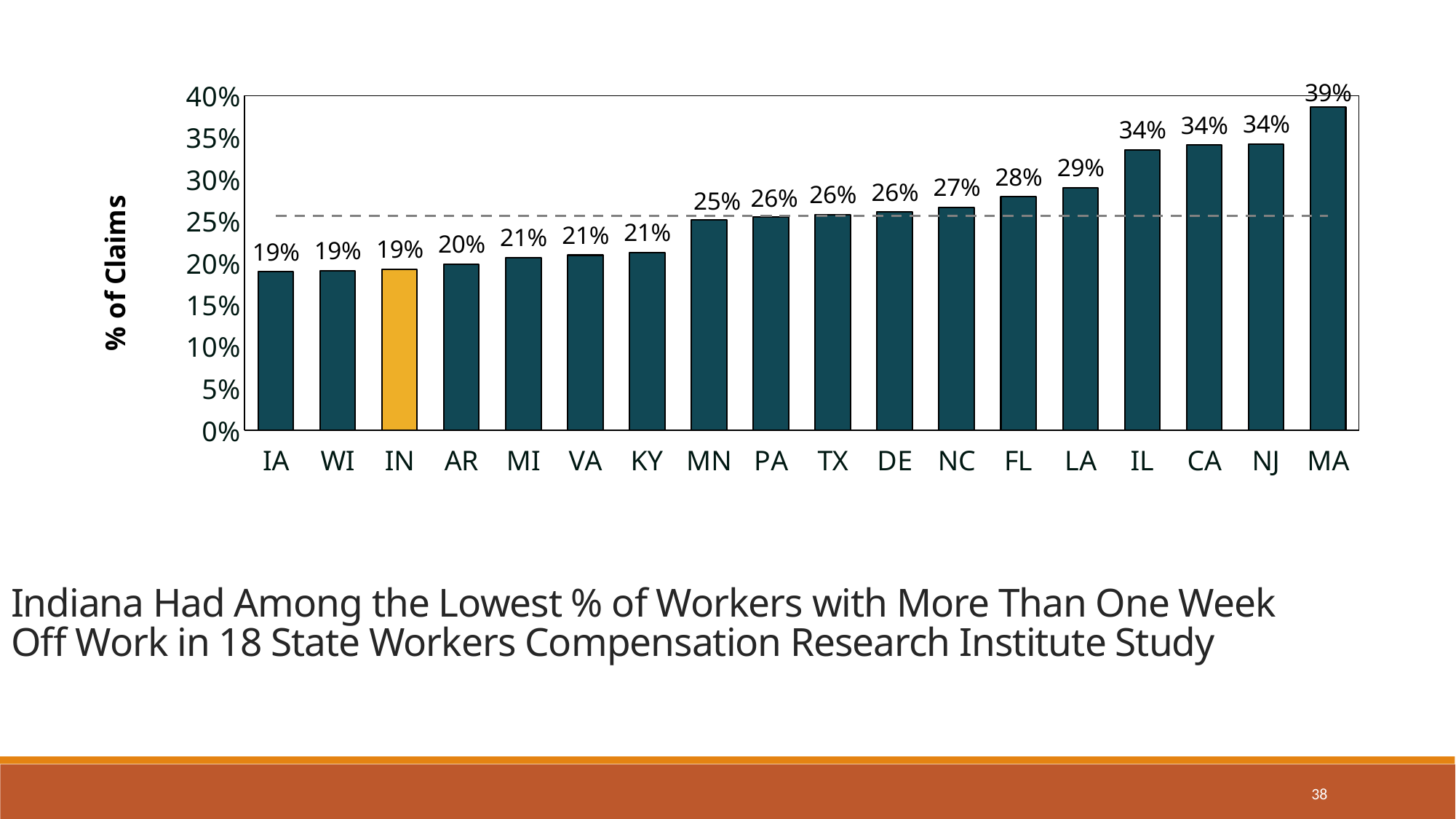
What is the value for IN? 19% Is the value for KY greater or less than 25%? less What is the value for MN? 25% What kind of chart is this? bar chart How many states are shown on the x axis? 18 What is the value for MA? 39% What is the value for FL? 28% What is the difference between the values for MA and IN? 20% Which state has the highest value? MA Which bar is highlighted in a different colour (gold) from the others? IN Which is larger, the value for IL or the value for NC? IL What is the difference between the values for LA and AR? 9%